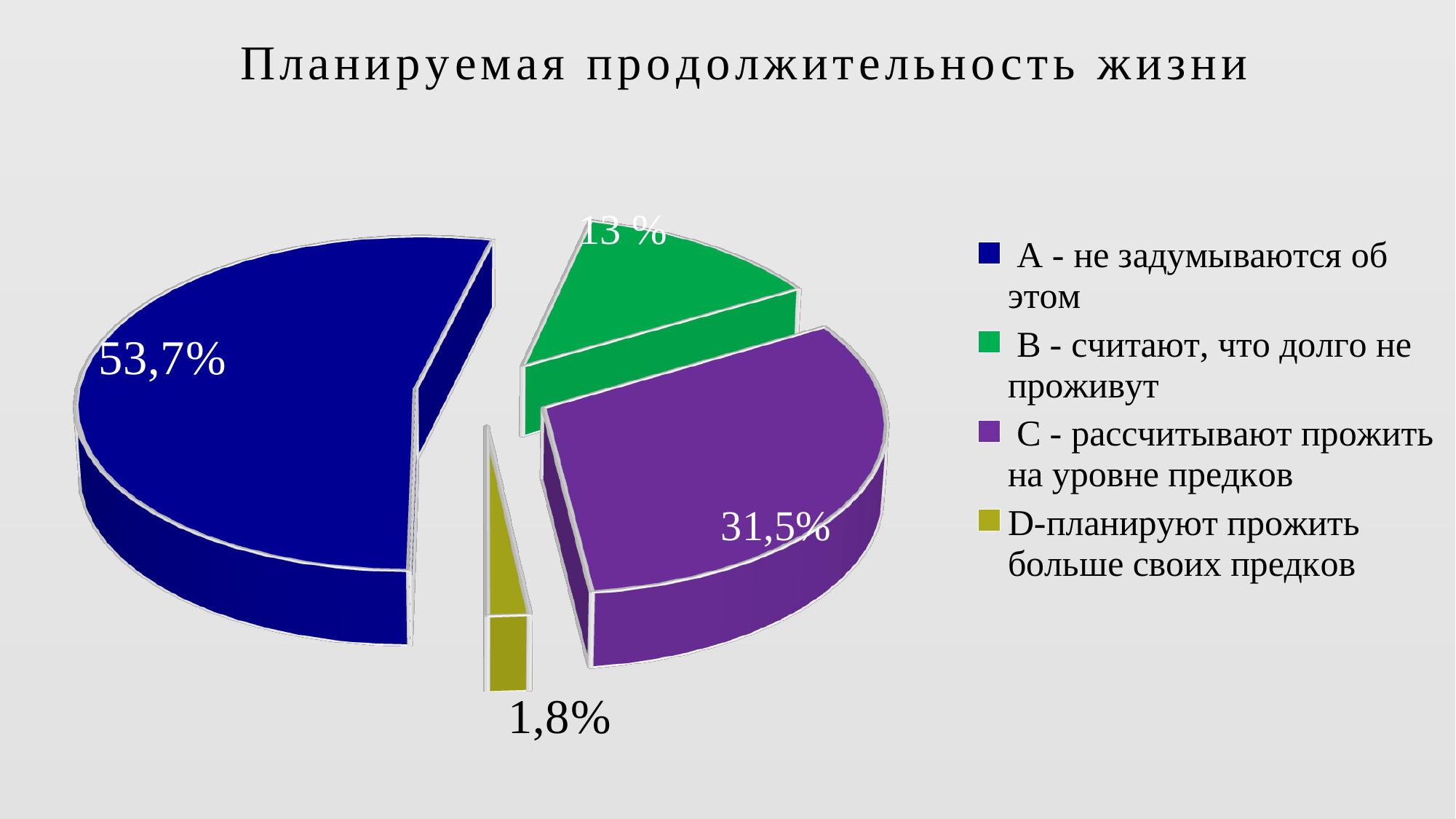
How many slices does the pie chart have? 4 Which category has the largest slice of the pie? A - не задумываются об этом What value is shown for category B (считают, что долго не проживут)? 13 % What share of the pie is category A (не задумываются об этом)? 53,7% Which is larger, the value for category B or the value for category C? Category C What kind of chart is shown on the slide? Pie chart What value is shown for category C (рассчитывают прожить на уровне предков)? 31,5% What value is shown for category D (планируют прожить больше своих предков)? 1,8% Which category has the smallest slice of the pie? D-планируют прожить больше своих предков What is the difference between the values for category A and category C? 22,2% What is the title of the chart? Планируемая продолжительность жизни How many entries does the legend list? 4